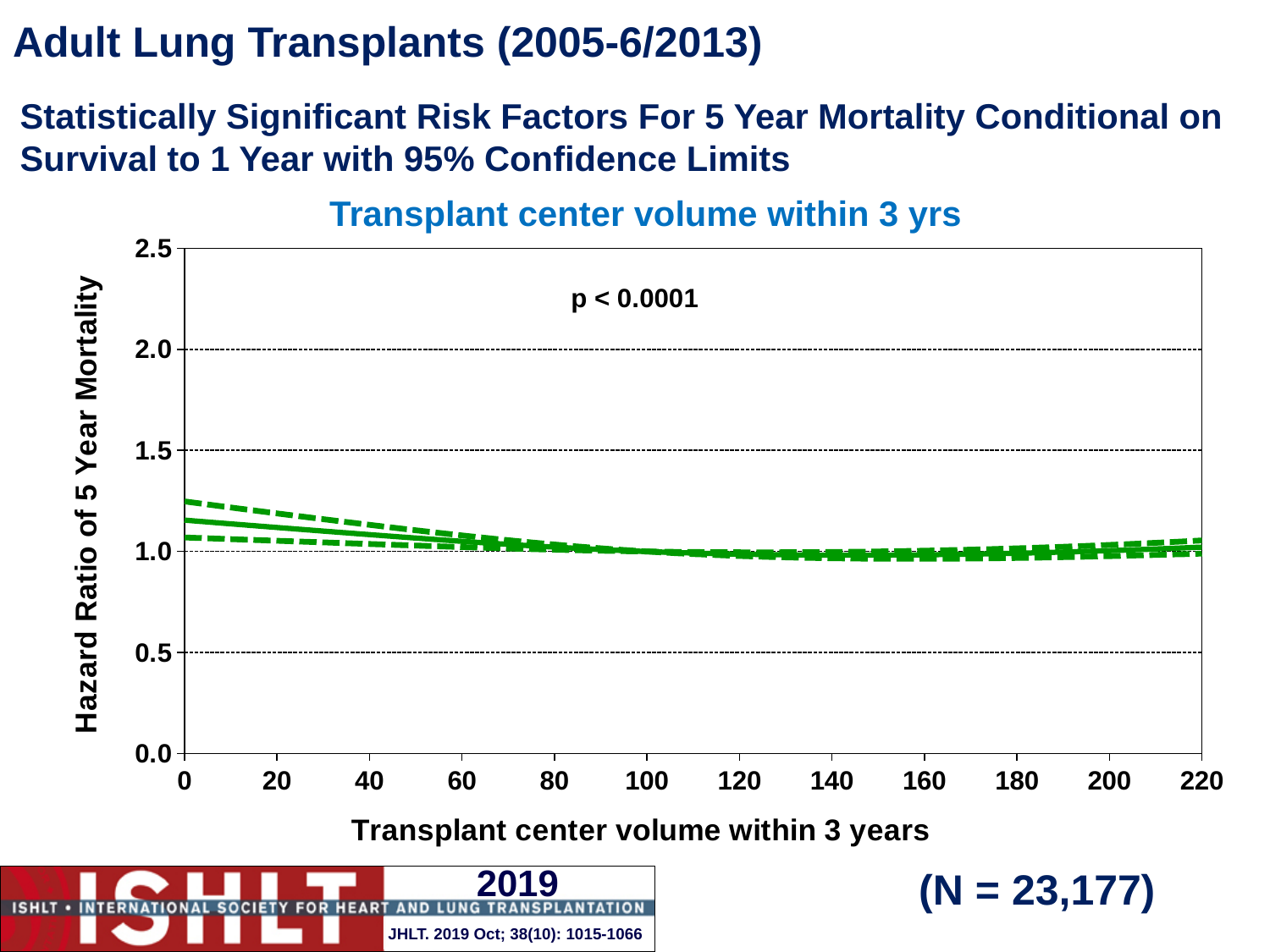
Is the hazard ratio at a transplant center volume of 0 greater or less than 1.5? less What is the label of the y axis? Hazard Ratio of 5 Year Mortality What kind of chart is shown on the slide? line chart Is the hazard ratio at a transplant center volume of 100 greater or less than 0.5? greater Does the hazard ratio rise or fall as transplant center volume increases from 0 to 100? falls Is the hazard ratio at a transplant center volume of 140 greater or less than 1.5? less What p-value is printed on the chart? p < 0.0001 What is the highest value shown on the y axis? 2.5 What is the title of the chart? Transplant center volume within 3 yrs What is the highest value shown on the x axis? 220 What is the sample size (N) shown on the slide? N = 23,177